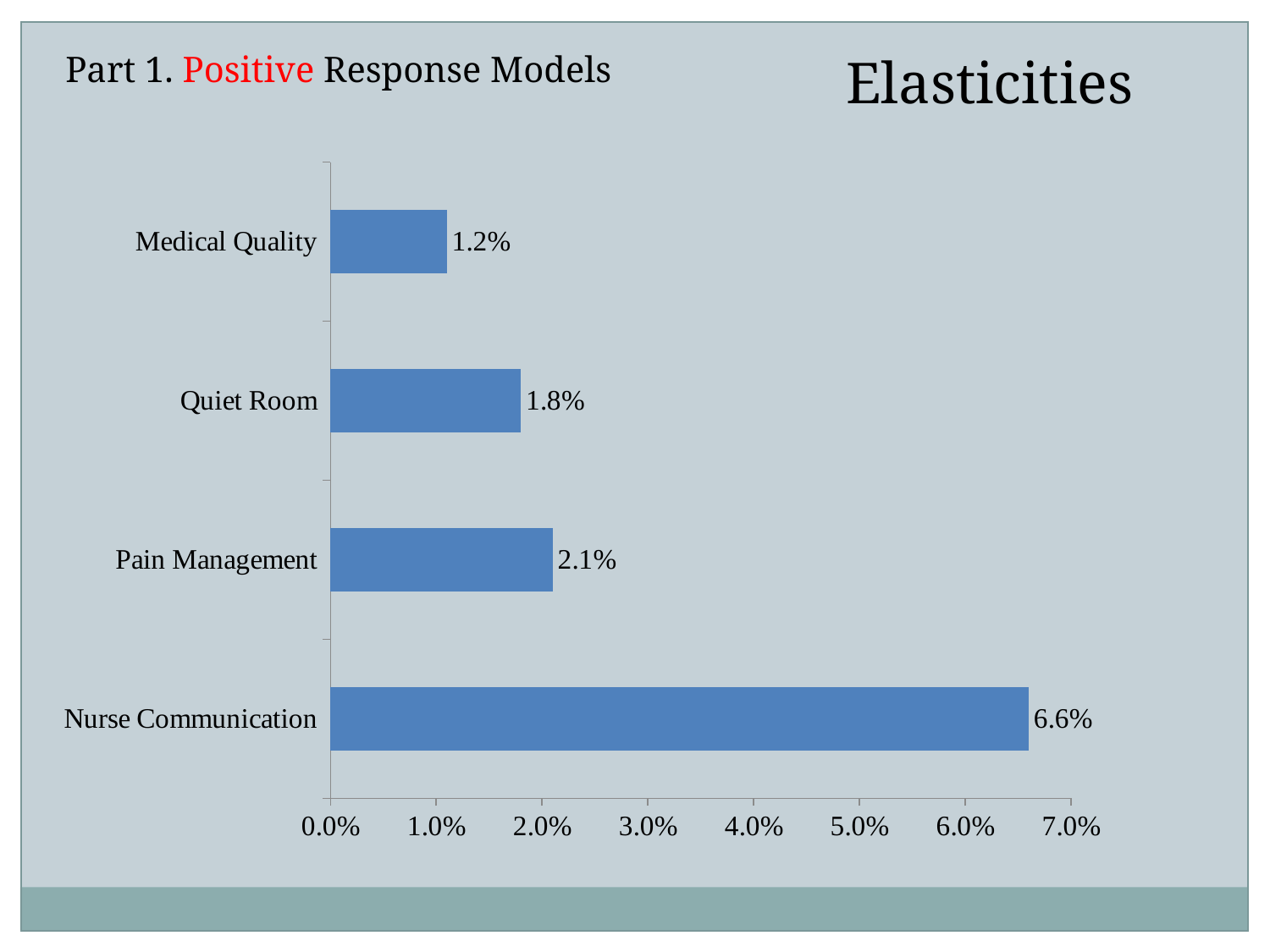
What is the elasticity value for Pain Management? 2.1% What is the difference between the elasticity for Nurse Communication and Pain Management? 4.5% What is the elasticity value for Quiet Room? 1.8% How many categories are shown in the chart? 4 Which category has the lowest elasticity? Medical Quality What kind of chart is shown on the slide? Bar chart Is the value for Nurse Communication greater or less than 6.0%? greater What is the difference between the elasticity for Quiet Room and Medical Quality? 0.6% What is the elasticity value for Medical Quality? 1.2% What is the elasticity value for Nurse Communication? 6.6% Which category has the highest elasticity? Nurse Communication Which has a larger elasticity, Pain Management or Quiet Room? Pain Management